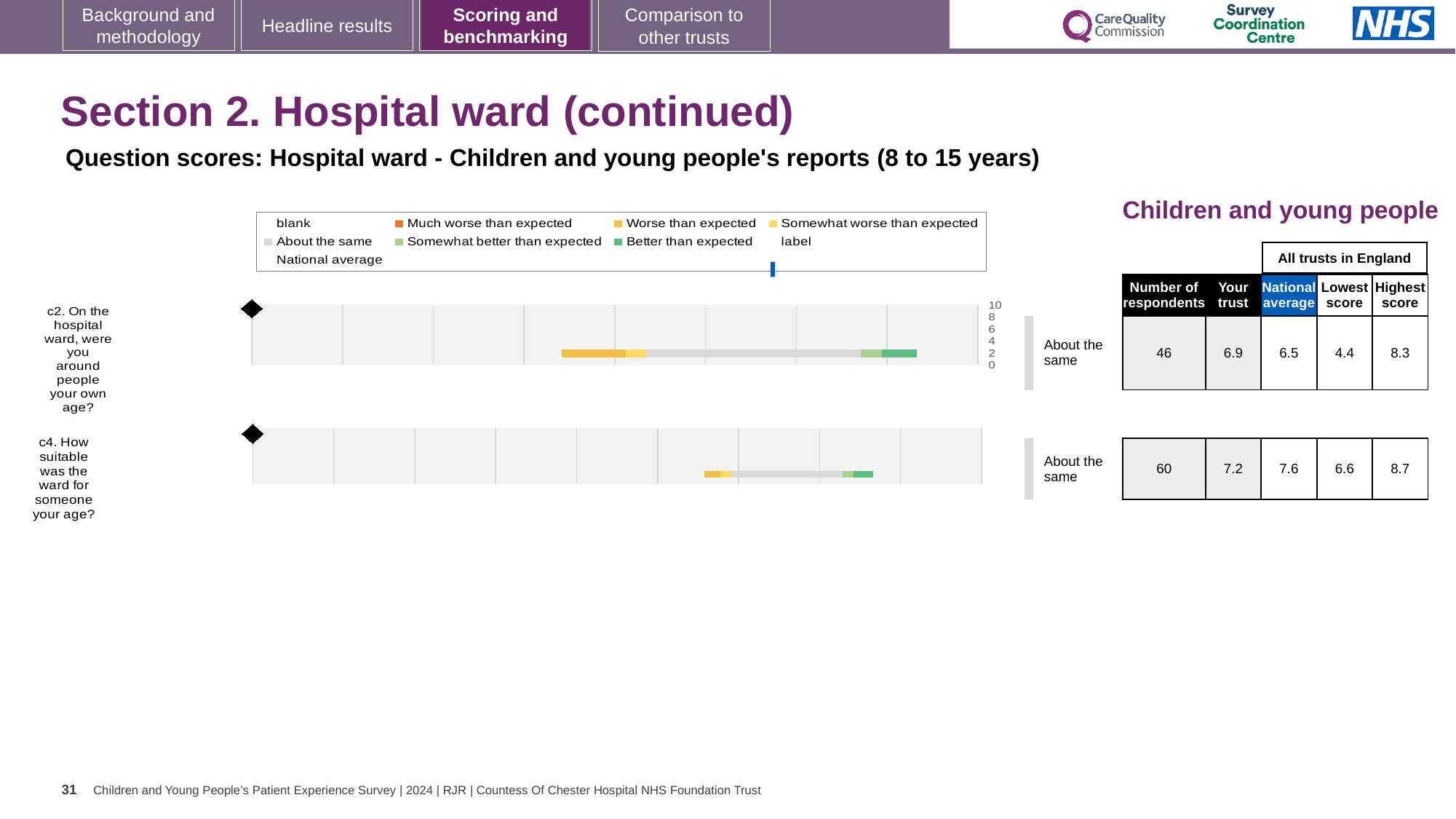
What is the difference between the highest score and the lowest score for question c2? 3.9 What is the 'Your trust' score for question c2 (On the hospital ward, were you around people your own age?)? 6.9 What benchmark rating is shown next to both question c2 and question c4? About the same What is the highest score among all trusts in England for question c4? 8.7 For question c4, is the 'Your trust' score higher or lower than the national average? Lower What heading appears above the table to the right of the charts? Children and young people How many respondents answered question c2? 46 What is the national average score for question c4 (How suitable was the ward for someone your age?)? 7.6 What is the lowest score among all trusts in England for question c2? 4.4 Which question had more respondents, c2 or c4? c4 What kind of chart is used to show the question scores for c2 and c4? Bar chart How many questions are plotted on the slide? 2